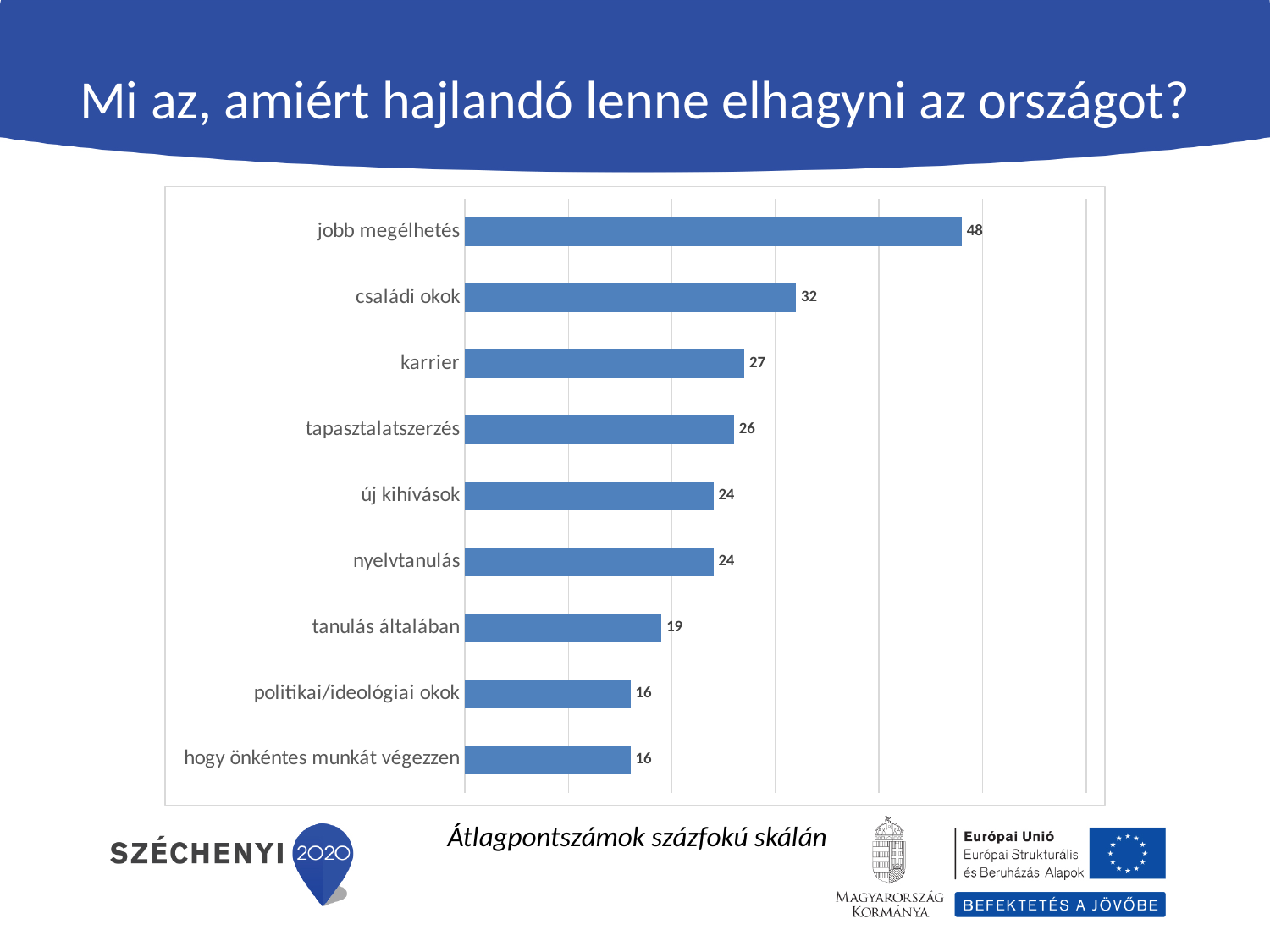
What is the difference between the values for jobb megélhetés and családi okok? 16 What is the value for jobb megélhetés? 48 What is the value for családi okok? 32 Which category has the highest value? jobb megélhetés What is the difference between the values for karrier and tanulás általában? 8 What is the value for politikai/ideológiai okok? 16 How many categories are shown in the chart? 9 What kind of chart is shown on the slide? bar chart What is the title of the slide? Mi az, amiért hajlandó lenne elhagyni az országot? Which is larger, the value for családi okok or the value for karrier? családi okok What is the value for tanulás általában? 19 Which is larger, the value for új kihívások or the value for politikai/ideológiai okok? új kihívások